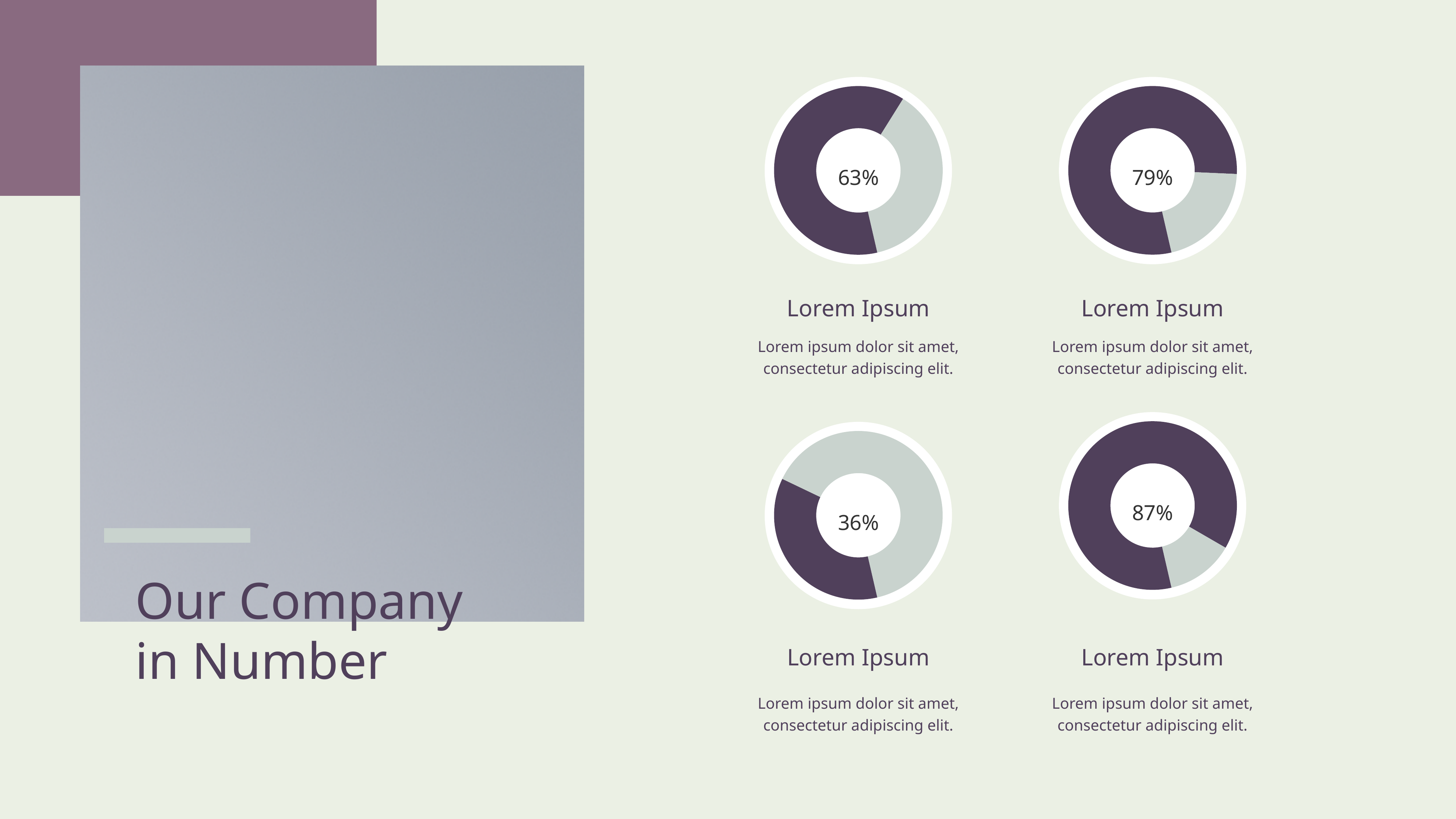
What is the difference between the percentage in the top-right donut chart and the percentage in the top-left donut chart? 16% What percentage is shown in the centre of the bottom-right donut chart? 87% What percentage is shown in the centre of the top-left donut chart? 63% What is the difference between the percentage in the bottom-right donut chart and the percentage in the bottom-left donut chart? 51% What kind of chart is used to display the percentages on the slide? Donut chart Which of the four donut charts shows the highest percentage? The bottom-right chart (87%) Which shows a larger percentage, the top-left donut chart or the bottom-left donut chart? The top-left chart What percentage is shown in the centre of the bottom-left donut chart? 36% What percentage is shown in the centre of the top-right donut chart? 79% How many donut charts are on the slide? 4 Which of the four donut charts shows the lowest percentage? The bottom-left chart (36%) What is the title text on the left side of the slide? Our Company in Number